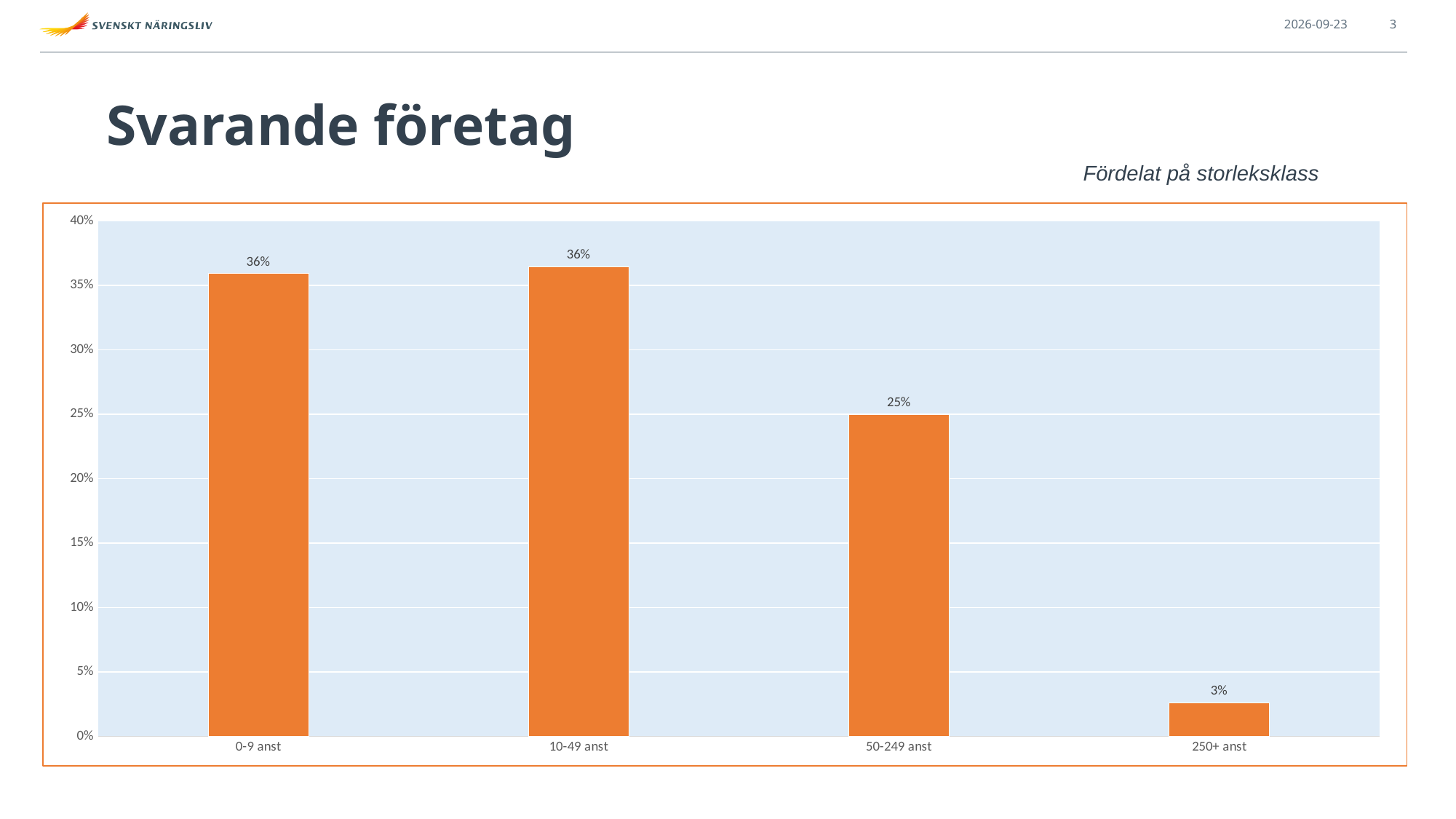
What is the value for 0-9 anst? 36% What is the value for 50-249 anst? 25% Which is larger, the value for 50-249 anst or the value for 250+ anst? 50-249 anst What kind of chart is shown on the slide? bar chart What is the subtitle shown above the chart? Fördelat på storleksklass What is the difference between the values for 10-49 anst and 50-249 anst? 11 percentage points How many categories are shown on the x axis? 4 Which category has the lowest value? 250+ anst Is the value for 50-249 anst greater or less than 20%? greater What is the value for 250+ anst? 3% What is the value for 10-49 anst? 36% What is the difference between the values for 50-249 anst and 250+ anst? 22 percentage points